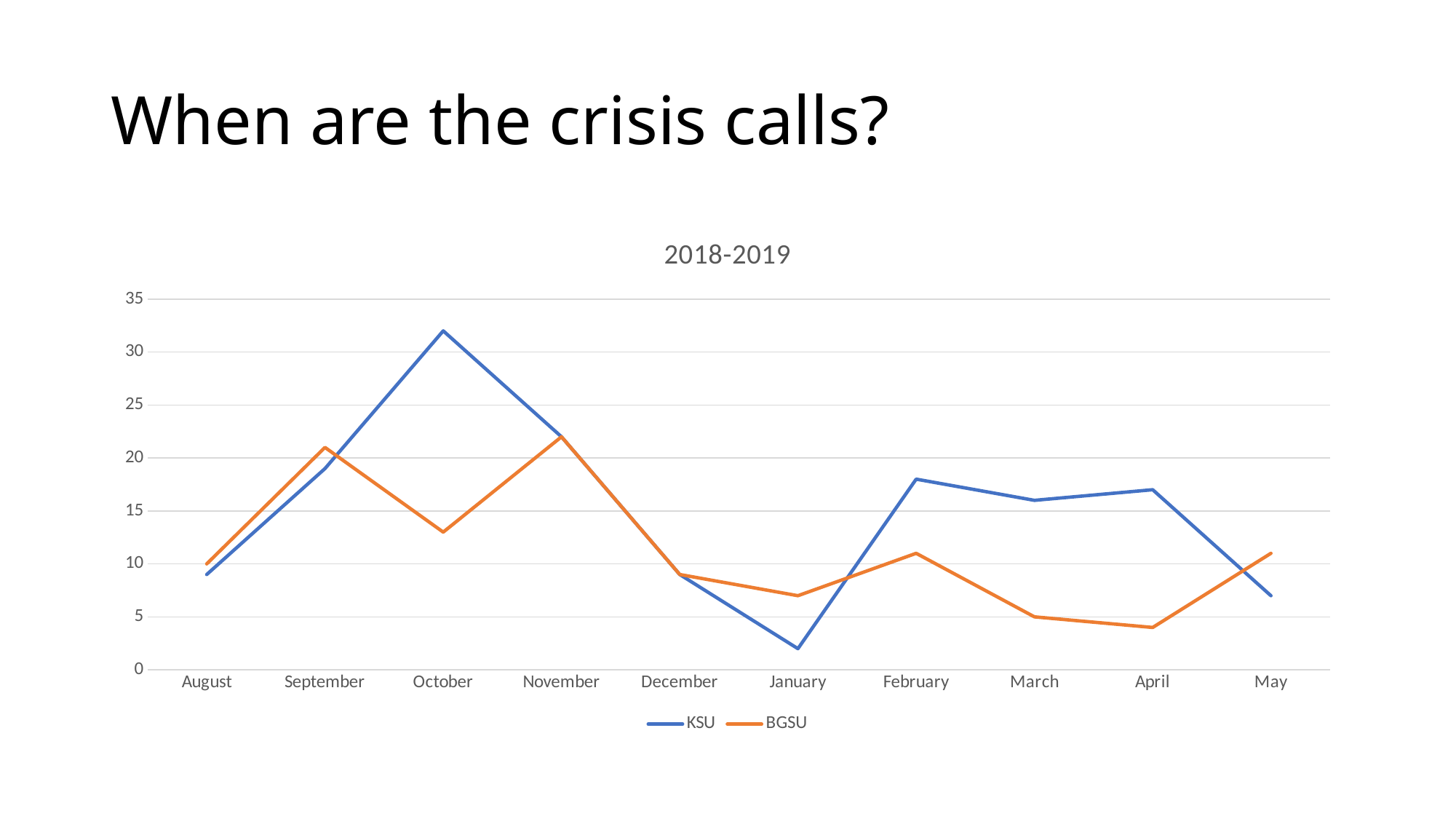
In which month does the KSU line reach its highest value? October In which month does the KSU line reach its lowest value? January What kind of chart is shown on the slide? line chart Which series has the higher value in May, KSU or BGSU? BGSU Which series has the higher value in October, KSU or BGSU? KSU How many series does the legend list? 2 Does the KSU line rise or fall from October to January? fall Is the KSU value for January greater or less than 5? less Is the BGSU value for October greater or less than 10? greater Is the KSU value for October greater or less than 30? greater How many months are shown along the x axis? 10 What is the title of the chart? 2018-2019